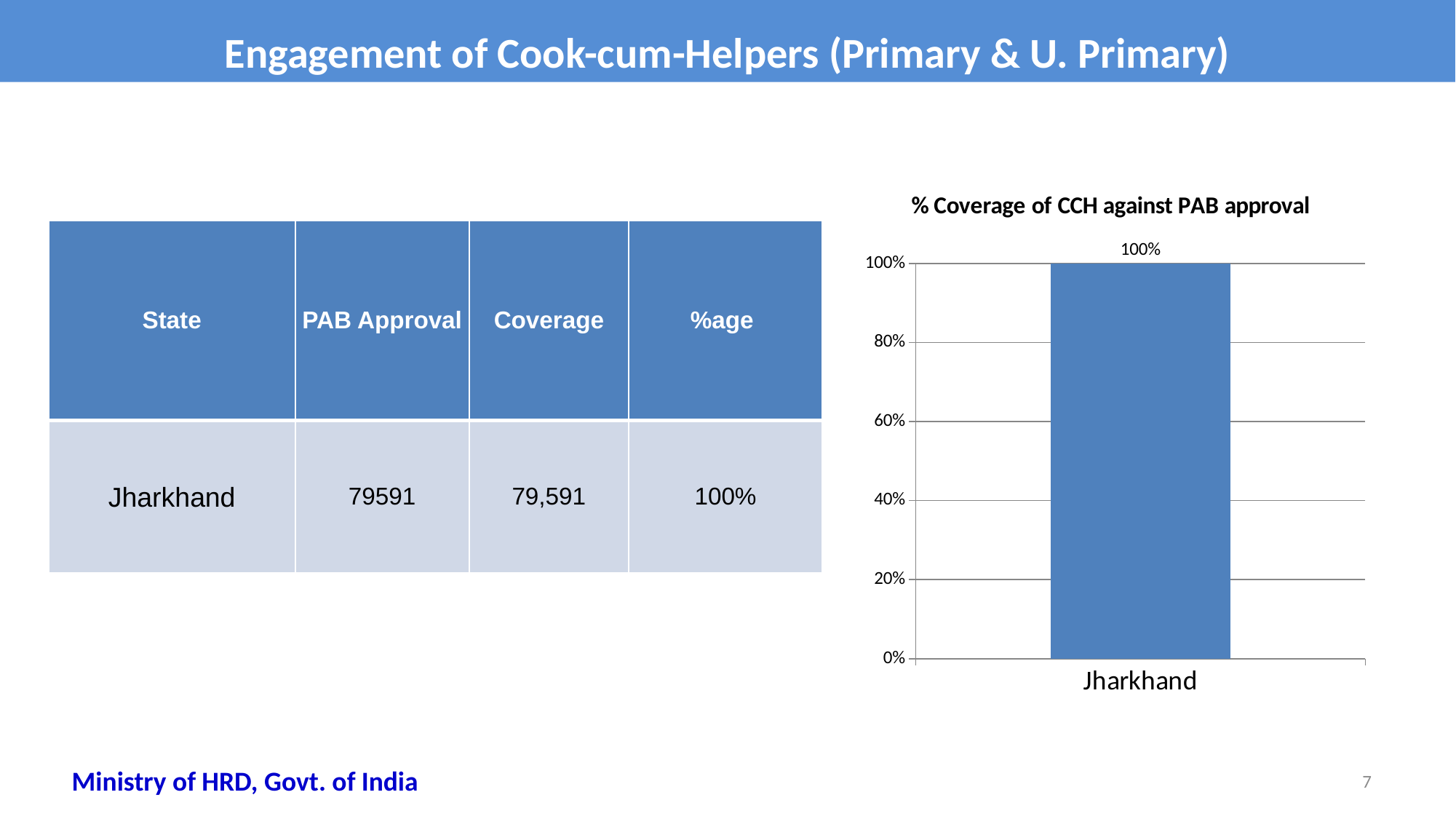
What is the highest value shown on the chart's y axis? 100% What kind of chart is shown on the slide? bar chart What is the title of the chart? % Coverage of CCH against PAB approval What is the value for Jharkhand in the chart? 100% How many categories are plotted in the chart? 1 Is the value for Jharkhand greater or less than 80%? greater Which category is shown on the x axis of the chart? Jharkhand